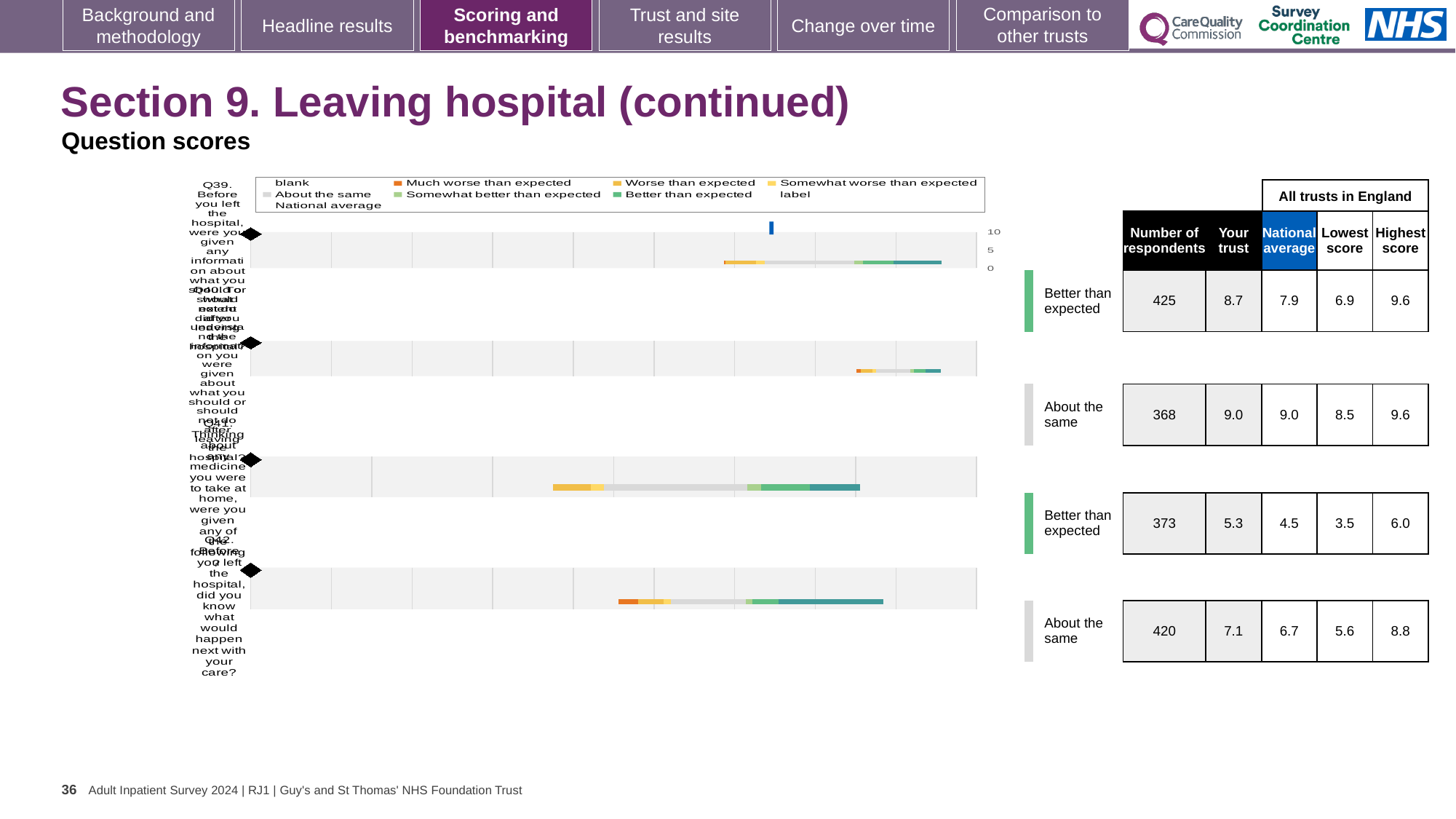
In the table beside the chart, what is the difference between the 'Your trust' score and the national average for the first row (Q39)? 0.8 In the table beside the chart, what is the national average for the first row (Q39)? 7.9 In the table beside the chart, which row has the highest 'Your trust' score? Q40 (9.0) In the table beside the chart, what is the 'Your trust' score for the third row (Q41)? 5.3 In the table beside the chart, how many respondents are listed for the second row (Q40)? 368 In the table beside the chart, what is the highest score for the fourth row (Q42)? 8.8 In the table beside the chart, what is the 'Your trust' score for the first row (Q39)? 8.7 How many question rows (bars) are plotted in the chart? 4 What is the title of the slide section above the chart? Section 9. Leaving hospital (continued) In the table beside the chart, is the 'Your trust' score for the fourth row (Q42) larger or smaller than its national average? larger In the table beside the chart, which row has the lowest 'Your trust' score? Q41 (5.3) What kind of chart is shown on the slide? bar chart